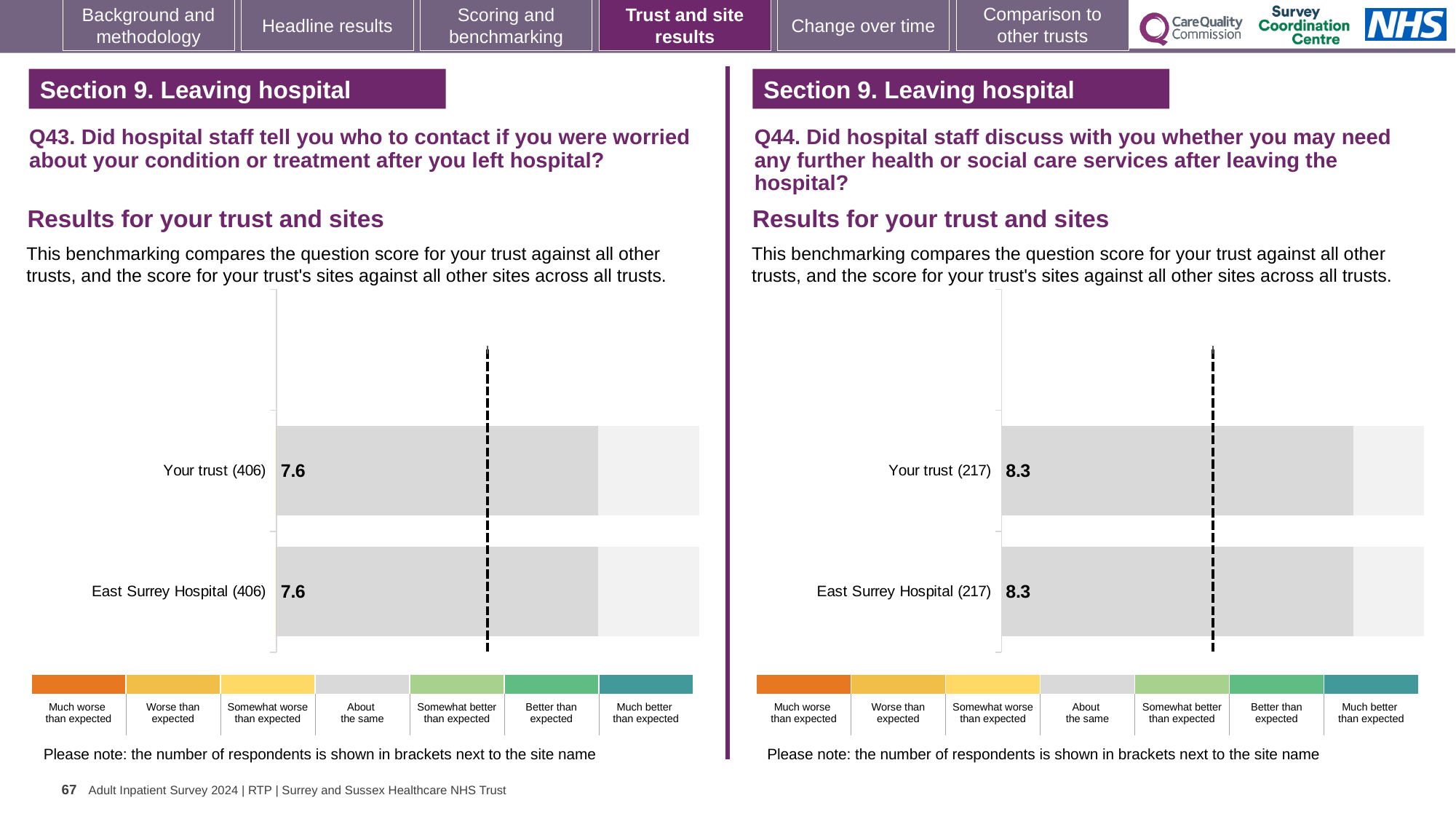
On the Q43 chart (left), what is the score for East Surrey Hospital? 7.6 On the Q43 chart (left), how many respondents are shown in brackets next to East Surrey Hospital? 406 How many bars are plotted on the Q43 chart (left)? 2 How many benchmark categories are listed in the colour key below the Q43 chart (left)? 7 What kind of chart is used on the Q44 chart (right)? bar chart On the Q44 chart (right), is the score for Your trust larger than, smaller than, or equal to the score for East Surrey Hospital? equal On the Q44 chart (right), what is the score for Your trust? 8.3 On the Q43 chart (left), what is the difference between the score for Your trust and the score for East Surrey Hospital? 0 How many bars are plotted on the Q44 chart (right)? 2 On the Q44 chart (right), what is the score for East Surrey Hospital? 8.3 On the Q43 chart (left), what is the score for Your trust? 7.6 On the Q44 chart (right), how many respondents are shown in brackets next to Your trust? 217